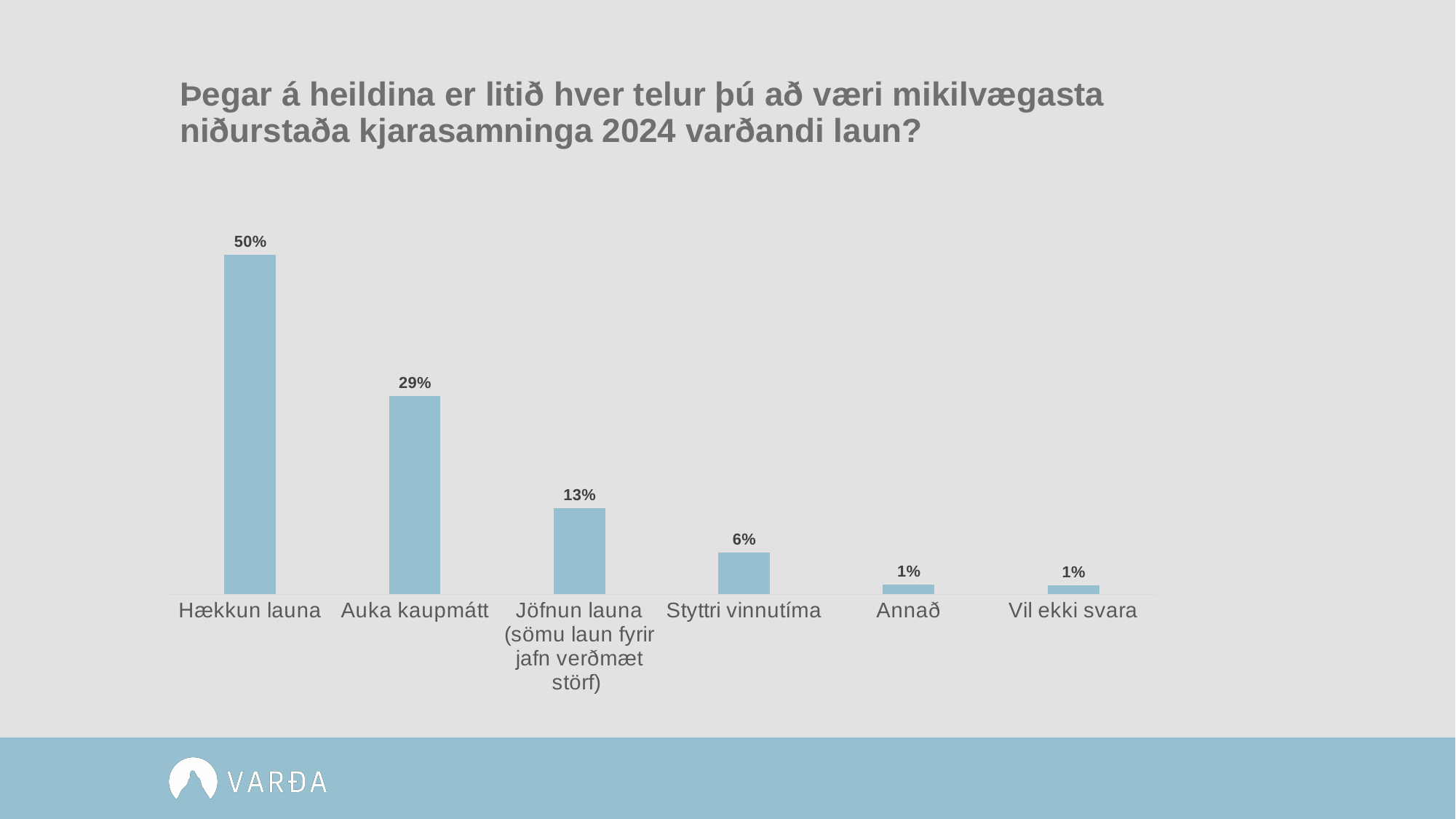
What is the value for Styttri vinnutíma? 6% What is the difference between the values for Hækkun launa and Auka kaupmátt? 21% What is the value for Auka kaupmátt? 29% Which category has the highest value? Hækkun launa What is the difference between the values for Auka kaupmátt and Jöfnun launa (sömu laun fyrir jafn verðmæt störf)? 16% What is the value for Annað? 1% Which is larger, the value for Styttri vinnutíma or the value for Jöfnun launa (sömu laun fyrir jafn verðmæt störf)? Jöfnun launa (sömu laun fyrir jafn verðmæt störf) What is the value for Jöfnun launa (sömu laun fyrir jafn verðmæt störf)? 13% What kind of chart is shown on the slide? Bar chart How many categories are shown on the chart? 6 What is the value for Hækkun launa? 50% Do the values rise or fall from left to right along the x axis? Fall